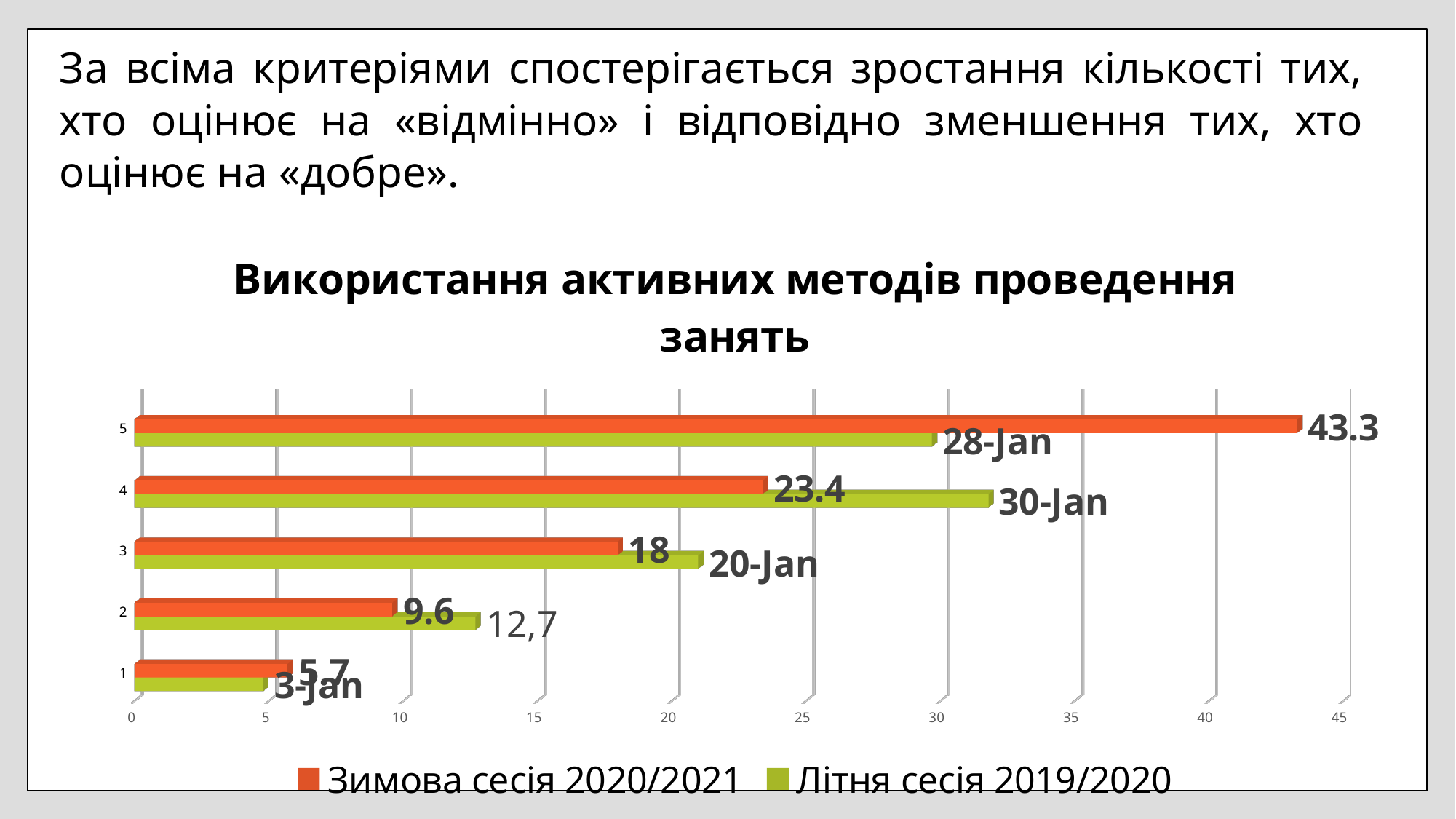
Which category has the lowest value in the Зимова сесія 2020/2021 series? 1 What kind of chart is shown on the slide? bar chart What is the difference between the Зимова сесія 2020/2021 values for category 5 and category 4? 19.9 How many series does the legend list? 2 What is the value for category 1 in the Зимова сесія 2020/2021 series? 5.7 What is the value for category 4 in the Зимова сесія 2020/2021 series? 23.4 For category 4, which series has the larger value: Зимова сесія 2020/2021 or Літня сесія 2019/2020? Літня сесія 2019/2020 What is the value for category 2 in the Літня сесія 2019/2020 series? 12,7 Which category has the highest value in the Зимова сесія 2020/2021 series? 5 Is the Літня сесія 2019/2020 value for category 4 greater or less than 30? greater How many categories are shown on the chart? 5 What is the value for category 5 in the Зимова сесія 2020/2021 series? 43.3